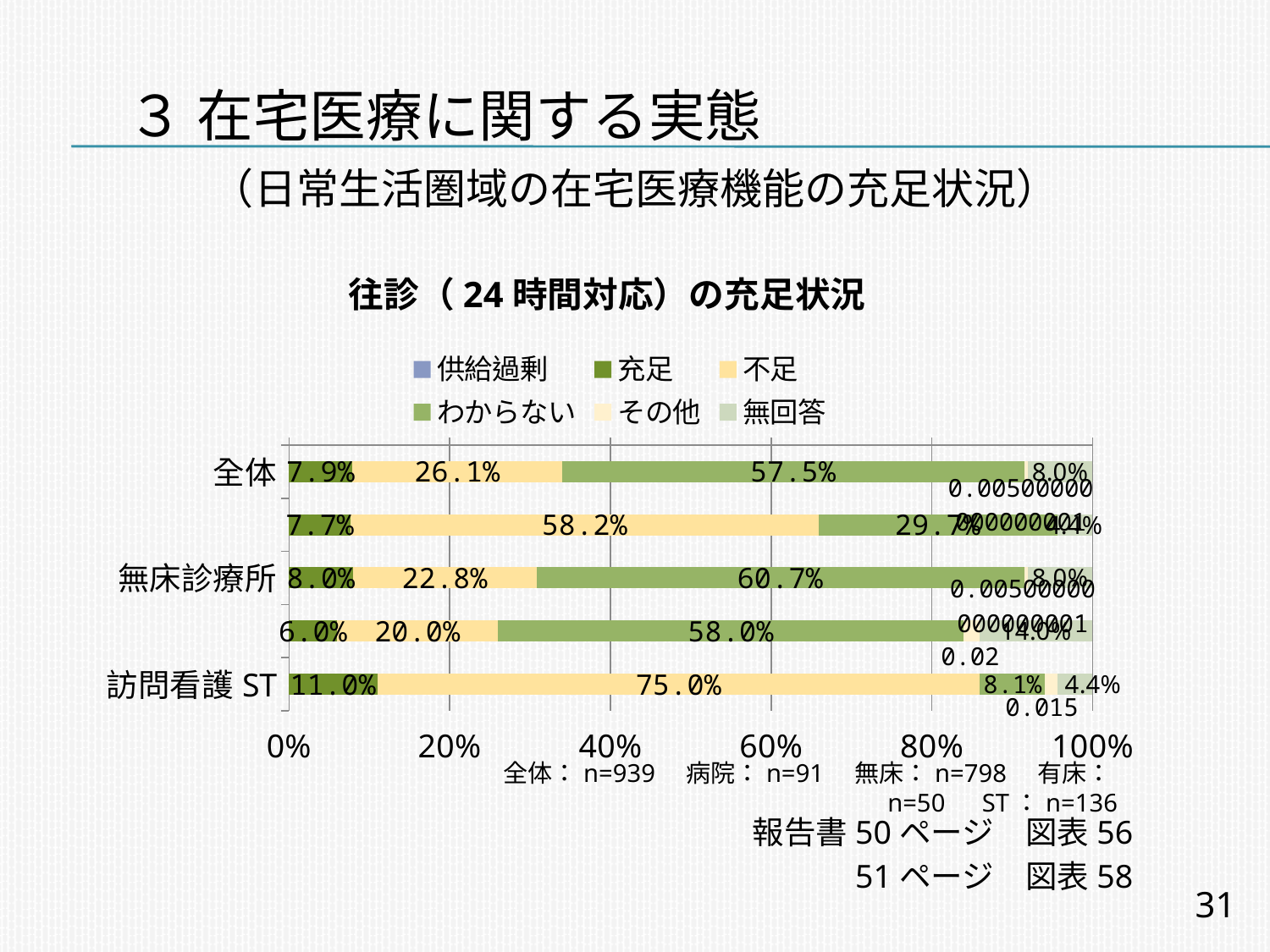
What is the 充足 value for 無床診療所? 8.0% What is the 無回答 value for 訪問看護ST? 4.4% What is the わからない value for 無床診療所? 60.7% Which is larger, the 不足 value for 訪問看護ST or the 不足 value for 全体? 訪問看護ST How many series does the legend list? 6 Is the 不足 value for 訪問看護ST greater or less than 60%? greater What is the 充足 value for 訪問看護ST? 11.0% What is the 不足 value for 全体? 26.1% What is the title of the chart? 往診（24時間対応）の充足状況 What is the 不足 value for 訪問看護ST? 75.0% What kind of chart is shown on the slide? stacked bar chart What is the difference between the わからない value for 無床診療所 and the わからない value for 全体? 3.2%